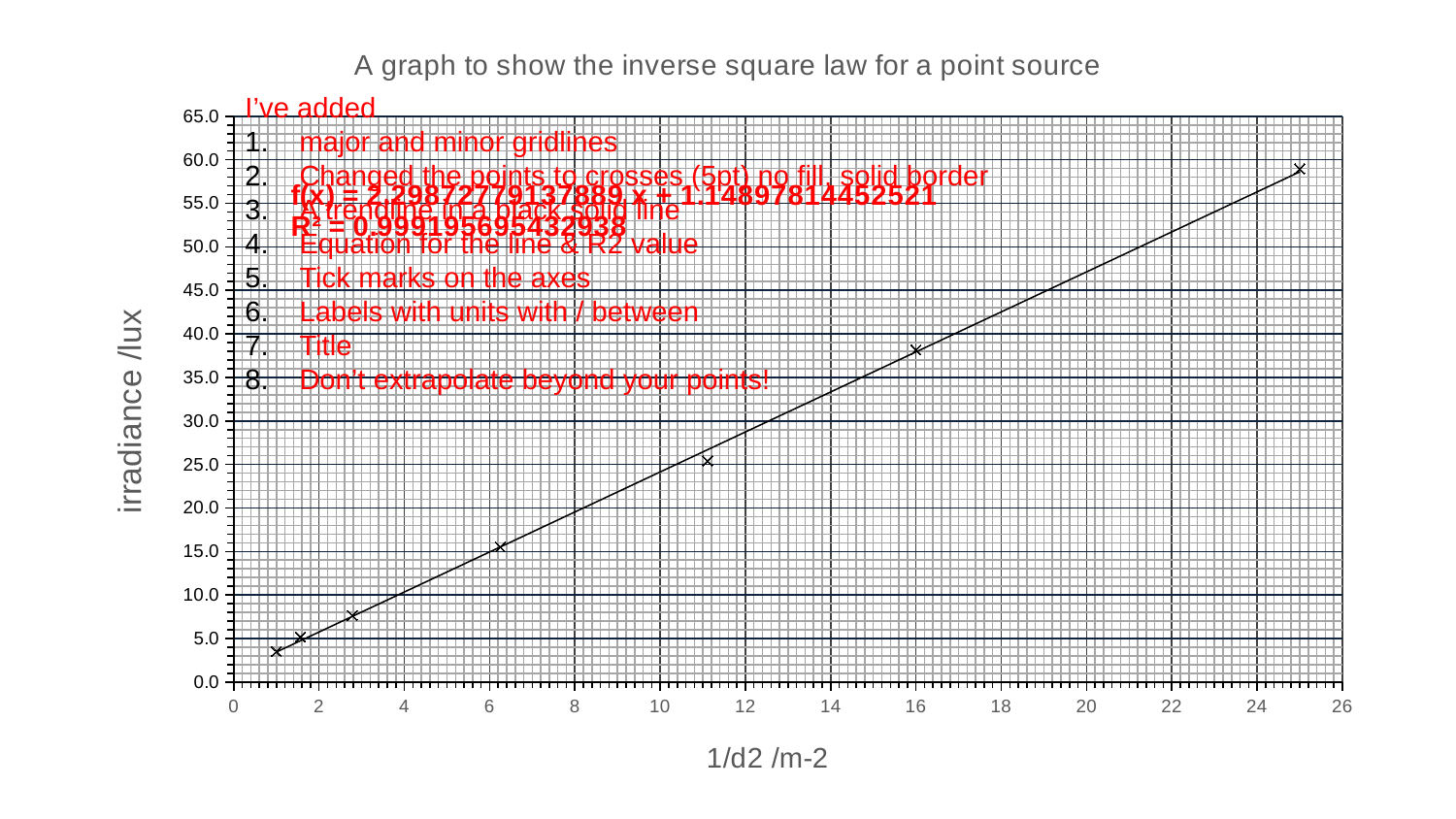
Do the irradiance values rise or fall as 1/d2 increases along the x axis? rise What is the label of the y axis? irradiance /lux How many data points are plotted on the chart? 7 Is the irradiance value for the point at 1/d2 = 25 greater or less than 55.0? greater Which plotted point has the highest irradiance: the one at 1/d2 = 25 or the one at 1/d2 = 16? the one at 1/d2 = 25 What is the maximum value shown on the y axis? 65.0 Is the irradiance value for the point near 1/d2 = 11 greater or less than 30.0? less Is the irradiance value for the point at 1/d2 = 16 greater or less than 40.0? less What kind of chart is shown on the slide? scatter chart What is the title of the chart? A graph to show the inverse square law for a point source